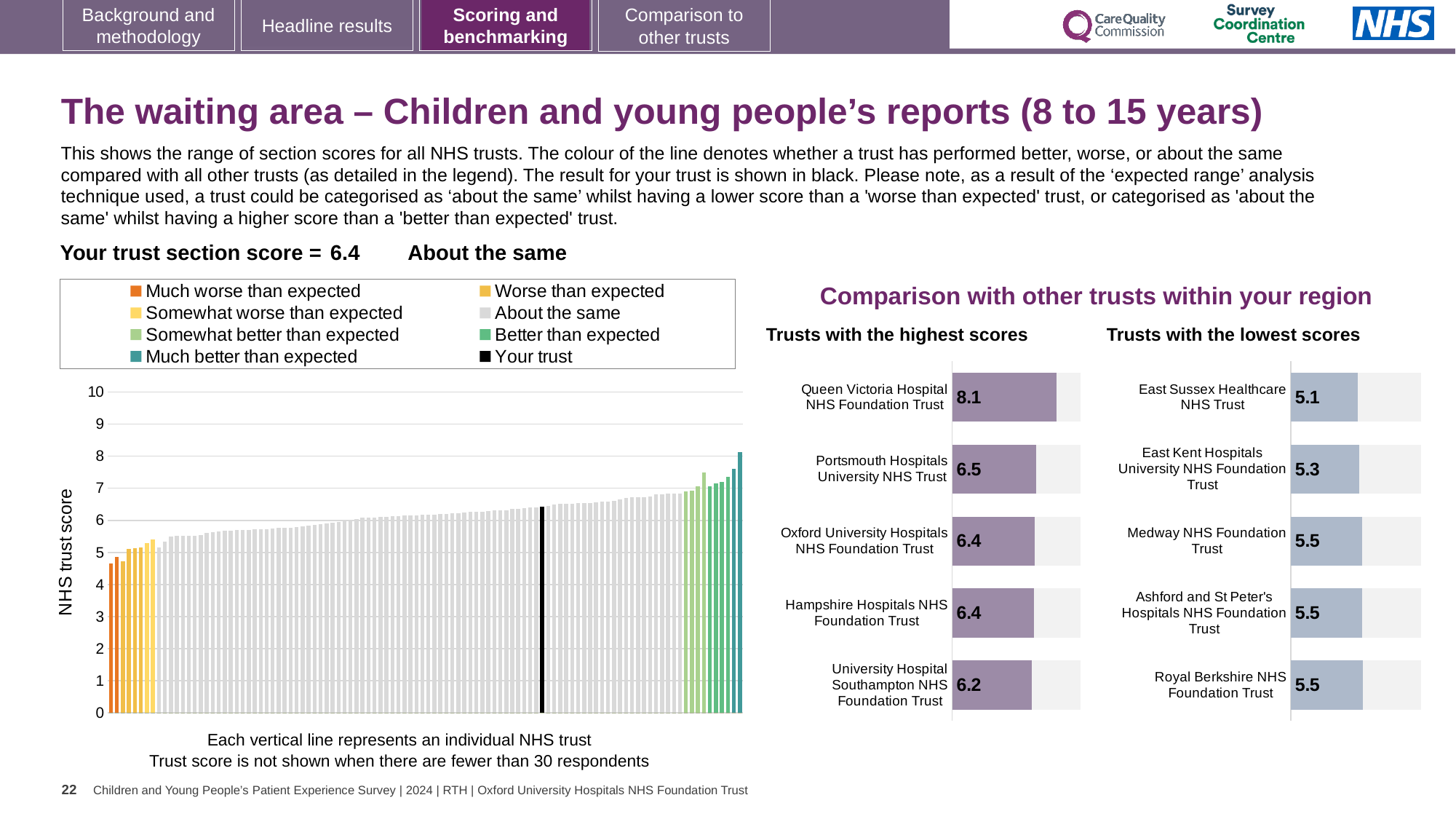
In the main chart on the left, what is the label on the vertical axis? NHS trust score In the 'Trusts with the highest scores' chart, which has the larger score: Portsmouth Hospitals University NHS Trust or University Hospital Southampton NHS Foundation Trust? Portsmouth Hospitals University NHS Trust In the main chart on the left, do the bars rise or fall from left to right? rise How many trusts are shown in the 'Trusts with the lowest scores' chart? 5 In the 'Trusts with the highest scores' chart, which trust has the highest score? Queen Victoria Hospital NHS Foundation Trust How many entries does the legend of the main chart on the left list? 8 In the main chart on the left, is the value of the black 'Your trust' bar greater or less than 6? greater In the 'Trusts with the highest scores' chart, what is the score for Queen Victoria Hospital NHS Foundation Trust? 8.1 In the 'Trusts with the lowest scores' chart, which trust has the lowest score? East Sussex Healthcare NHS Trust In the main chart on the left, is the value of the leftmost orange bar greater or less than 5? less In the 'Trusts with the highest scores' chart, what is the difference between the scores of Queen Victoria Hospital NHS Foundation Trust and University Hospital Southampton NHS Foundation Trust? 1.9 What kind of chart is the main chart on the left showing NHS trust scores? bar chart